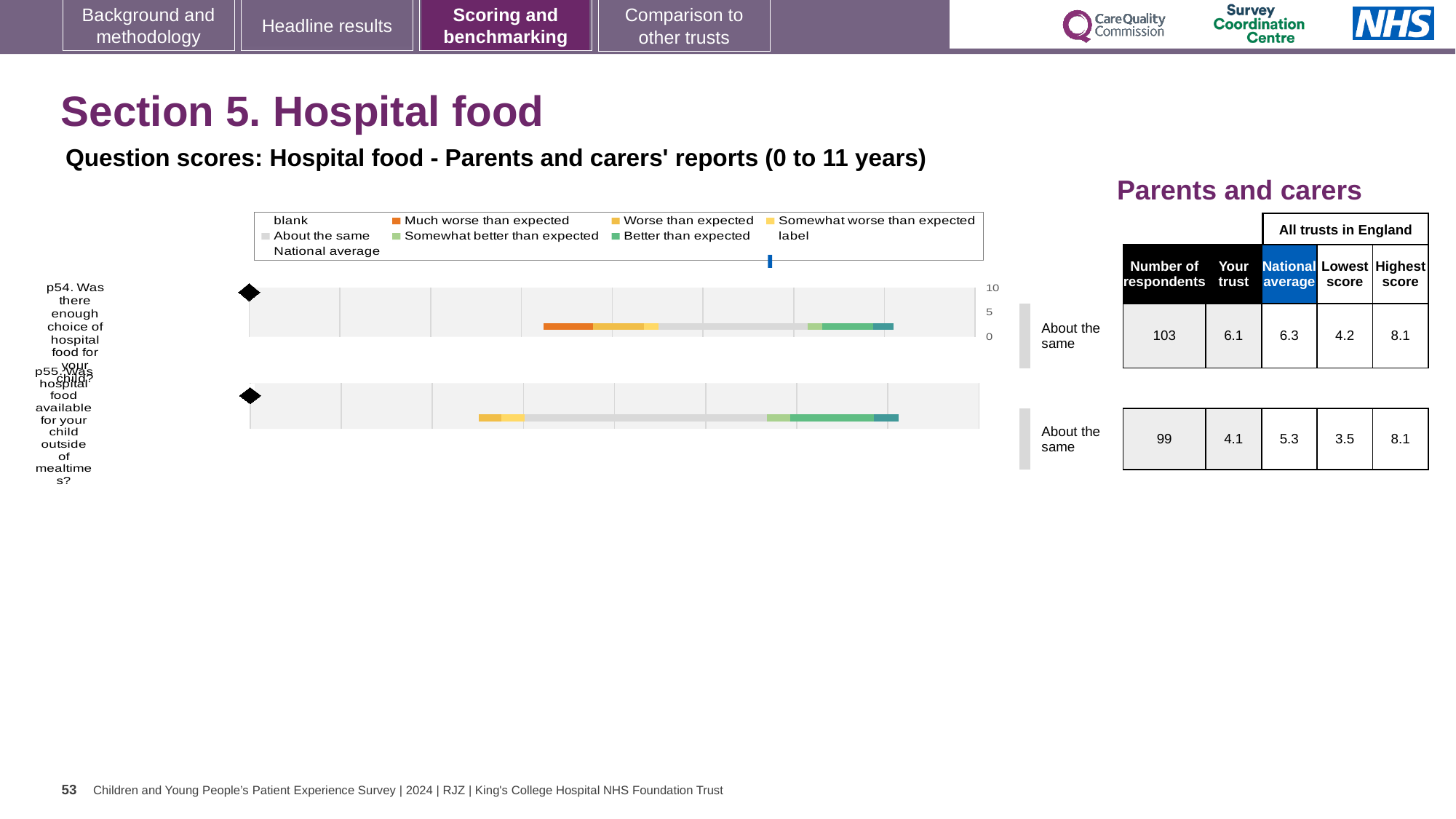
How many questions (categories) are plotted in the hospital food chart? 2 What is the 'Your trust' score for p54 (enough choice of hospital food for your child)? 6.1 Which colour in the legend represents 'Much worse than expected'? orange Which question has the higher 'Your trust' score, p54 or p55? p54 What is the national average score for p55 (hospital food available outside of mealtimes)? 5.3 What is the lowest score among all trusts in England for p55? 3.5 How many respondents answered p55? 99 What is the highest score among all trusts in England for p54? 8.1 What benchmark category is shown next to the bar for p54? About the same Is the 'Your trust' score for p55 greater or less than 5? less What kind of chart is used to show the question scores for hospital food? bar chart What is the difference between the national average and the 'Your trust' score for p54? 0.2